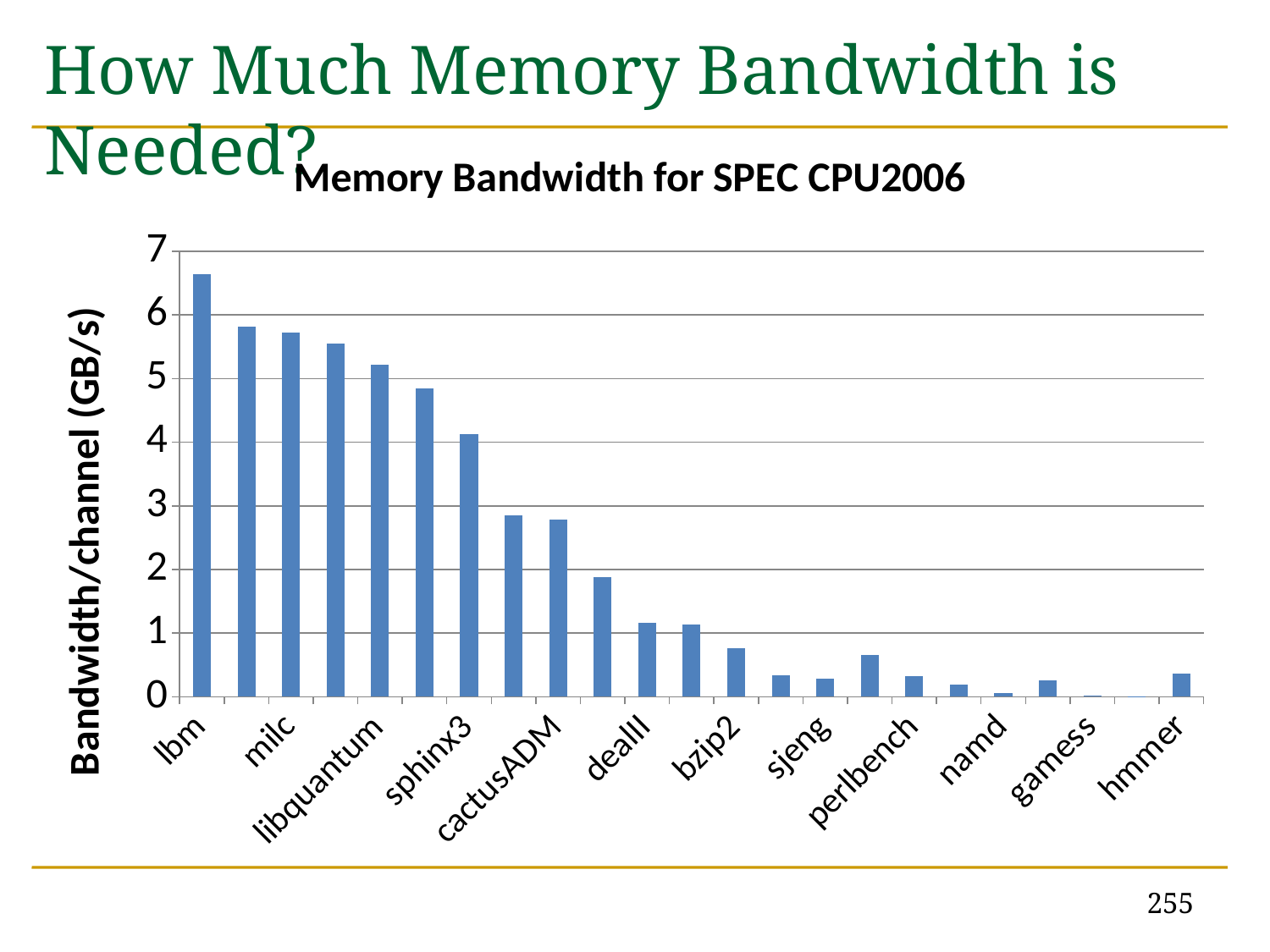
Is the value for lbm greater or less than 6? greater Which has a higher memory bandwidth, dealII or sjeng? dealII What is the title of the chart? Memory Bandwidth for SPEC CPU2006 Which has a higher memory bandwidth, lbm or milc? lbm Is the value for sphinx3 greater or less than 4? greater What type of chart is shown on the slide? Bar chart Which benchmark has the highest memory bandwidth? lbm What is the label of the vertical axis? Bandwidth/channel (GB/s) Do the bandwidth values generally rise or fall from left to right across the benchmarks? fall Is the value for libquantum greater or less than 5? greater